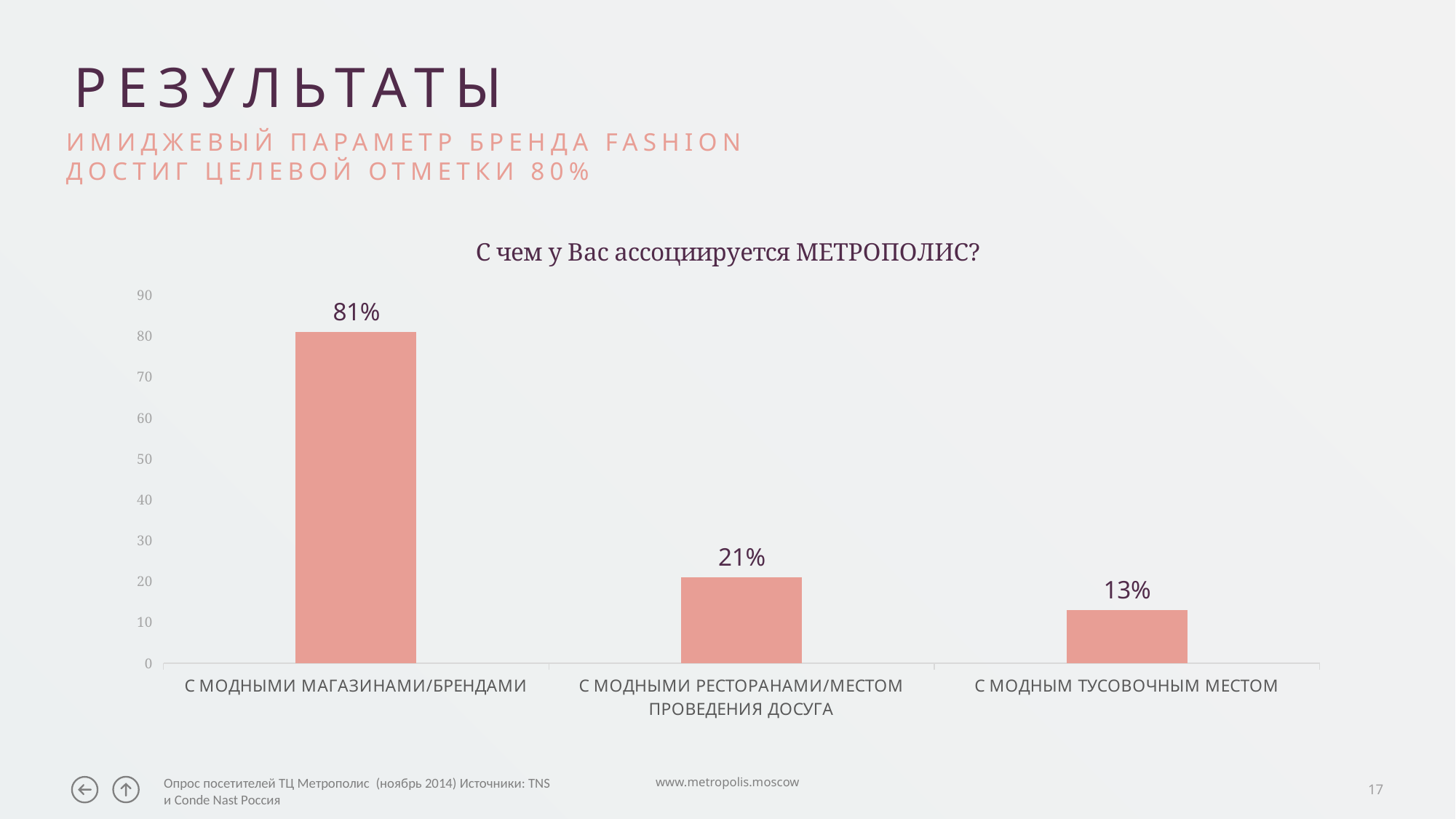
Which category has the highest value? С МОДНЫМИ МАГАЗИНАМИ/БРЕНДАМИ Which category has the lowest value? С МОДНЫМ ТУСОВОЧНЫМ МЕСТОМ What is the difference between the values for С МОДНЫМИ РЕСТОРАНАМИ/МЕСТОМ ПРОВЕДЕНИЯ ДОСУГА and С МОДНЫМ ТУСОВОЧНЫМ МЕСТОМ? 8% What kind of chart is shown on the slide? bar chart What is the value for С МОДНЫМИ РЕСТОРАНАМИ/МЕСТОМ ПРОВЕДЕНИЯ ДОСУГА? 21% Which is larger: the value for С МОДНЫМИ РЕСТОРАНАМИ/МЕСТОМ ПРОВЕДЕНИЯ ДОСУГА or С МОДНЫМ ТУСОВОЧНЫМ МЕСТОМ? С МОДНЫМИ РЕСТОРАНАМИ/МЕСТОМ ПРОВЕДЕНИЯ ДОСУГА How many categories are shown in the chart? 3 What is the title of the chart? С чем у Вас ассоциируется МЕТРОПОЛИС? Is the value for С МОДНЫМИ МАГАЗИНАМИ/БРЕНДАМИ greater or less than 80? greater What is the difference between the values for С МОДНЫМИ МАГАЗИНАМИ/БРЕНДАМИ and С МОДНЫМИ РЕСТОРАНАМИ/МЕСТОМ ПРОВЕДЕНИЯ ДОСУГА? 60% What is the value for С МОДНЫМИ МАГАЗИНАМИ/БРЕНДАМИ? 81% What is the value for С МОДНЫМ ТУСОВОЧНЫМ МЕСТОМ? 13%